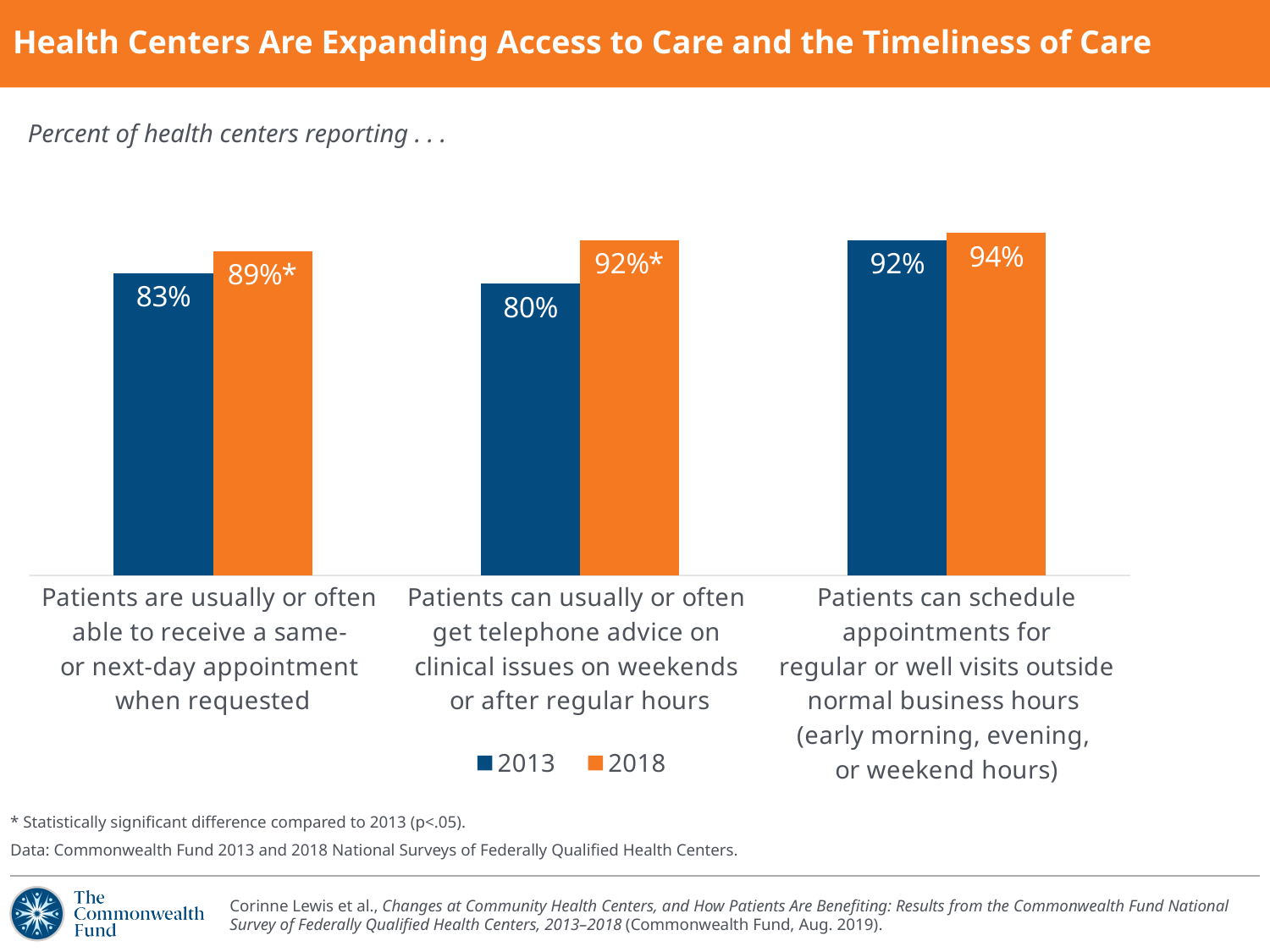
What is the difference between the 2013 and 2018 values for telephone advice on weekends or after regular hours? 12 percentage points Which category had the highest value in 2018? Patients can schedule appointments for regular or well visits outside normal business hours (early morning, evening, or weekend hours) What type of chart is shown on the slide? bar chart By how many percentage points did the share of health centers reporting same- or next-day appointments increase from 2013 to 2018? 6 percentage points What percent of health centers reported in 2018 that patients can usually or often get telephone advice on clinical issues on weekends or after regular hours? 92%* Which category had the lowest value in 2013? Patients can usually or often get telephone advice on clinical issues on weekends or after regular hours How many series does the legend list? 2 What percent of health centers reported in 2013 that patients are usually or often able to receive a same- or next-day appointment when requested? 83% Which year is represented by the orange bars? 2018 What percent of health centers reported in 2013 that patients can schedule appointments for regular or well visits outside normal business hours? 92% Is the 2018 value for same- or next-day appointments higher or lower than the 2013 value? higher How many categories are shown on the chart? 3